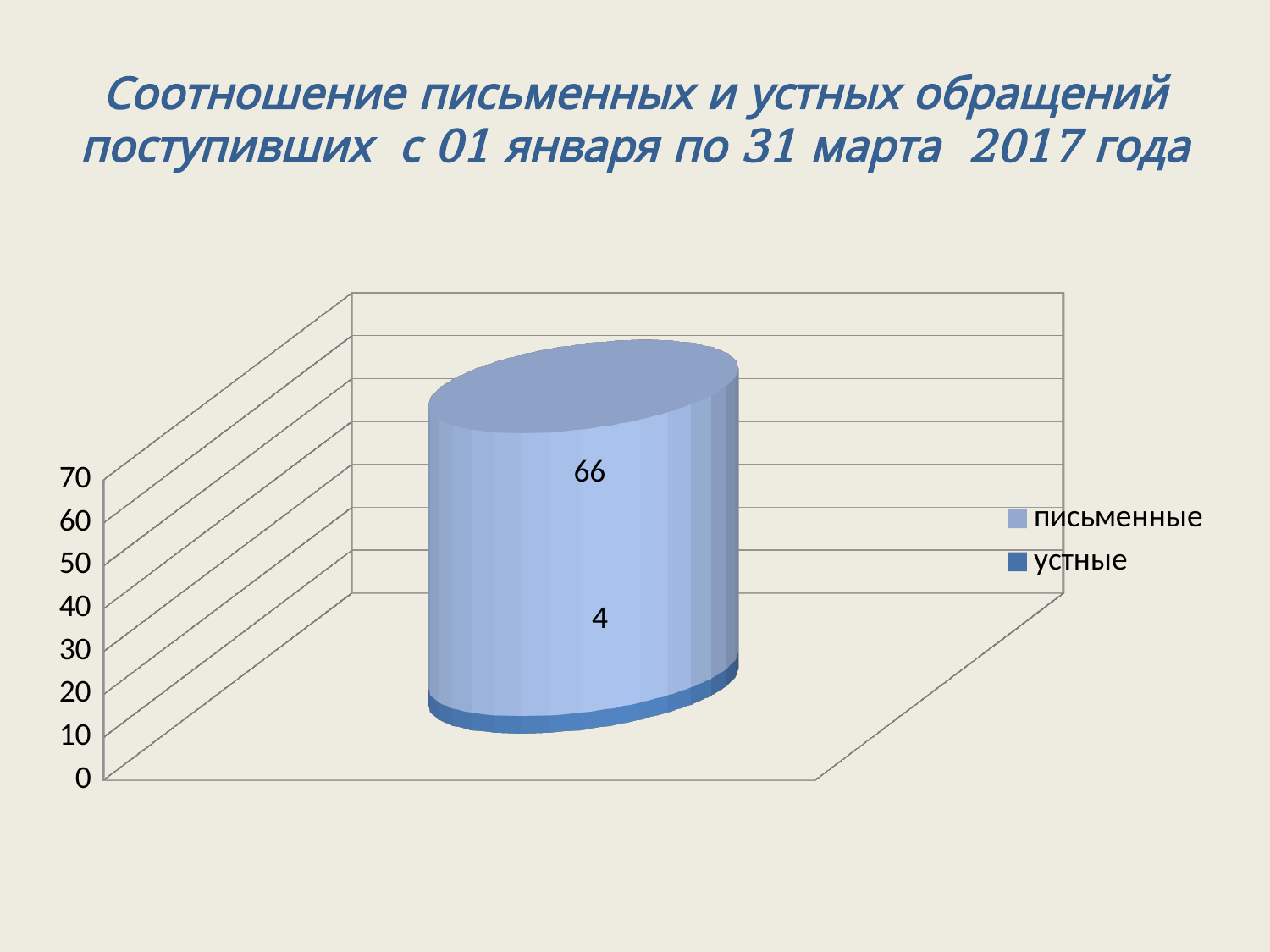
Is the value for устные greater or less than 10? less What is the value for the письменные series? 66 Which series has the smallest value? устные How many series does the legend list? 2 What is the total of the stacked bar? 70 What is the value for the устные series? 4 Which series has the larger value, письменные or устные? письменные What is the difference between the письменные value and the устные value? 62 What kind of chart is shown on the slide? bar chart Is the value for письменные greater or less than 50? greater Which series has the largest value? письменные What is the highest value shown on the vertical axis? 70